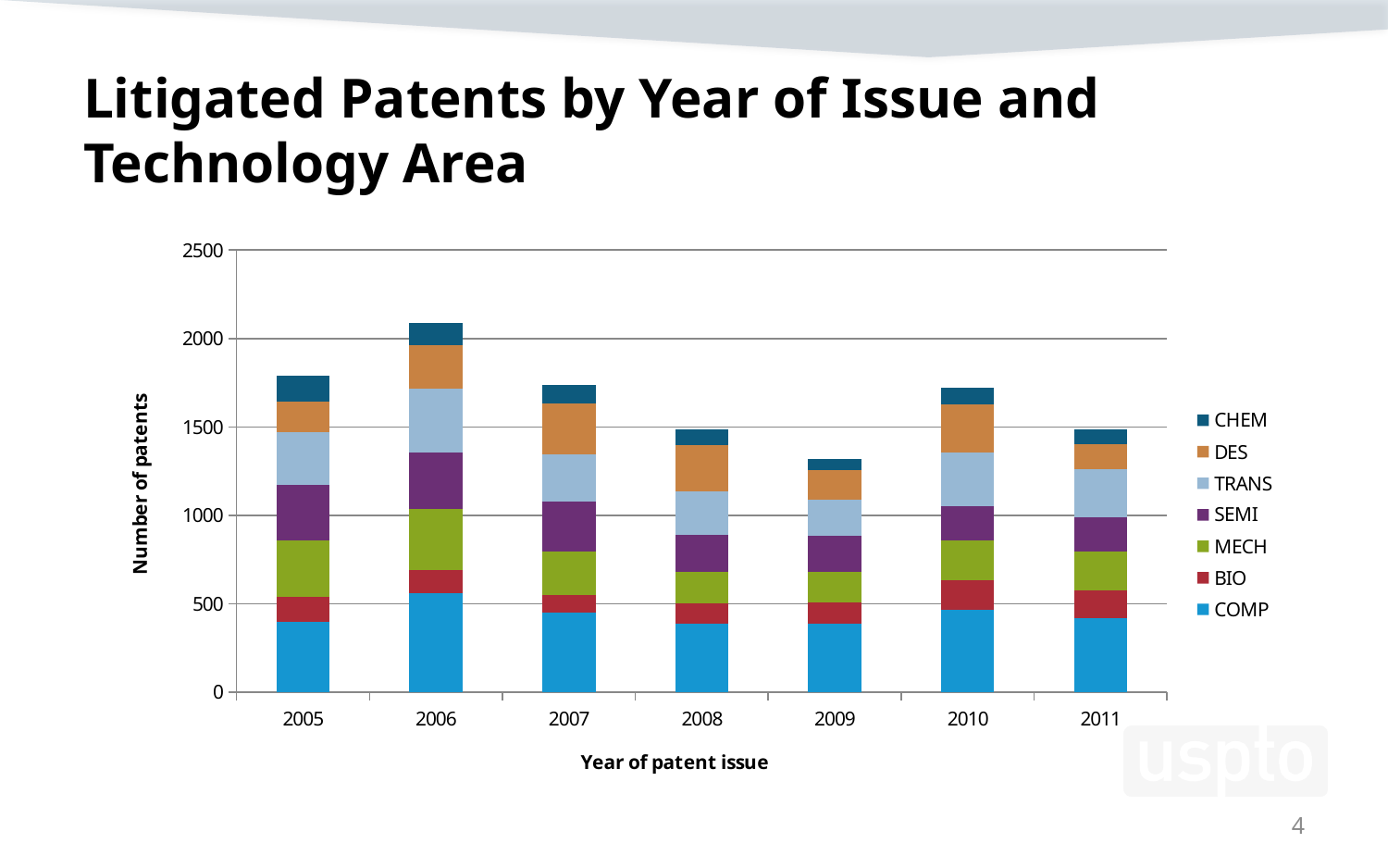
How many technology areas does the legend list? 7 Is the total number of litigated patents for 2006 greater or less than 2000? greater Which year has the tallest total bar? 2006 How many years are shown along the x axis? 7 Is the total number of litigated patents for 2009 greater or less than 1500? less Which year has the shortest total bar? 2009 From 2006 to 2009, do the total bar heights rise or fall? fall What is the label on the y axis? Number of patents Which year has a larger total bar, 2006 or 2009? 2006 What kind of chart is shown on the slide? Stacked bar chart Is the total number of litigated patents for 2005 greater or less than 1500? greater